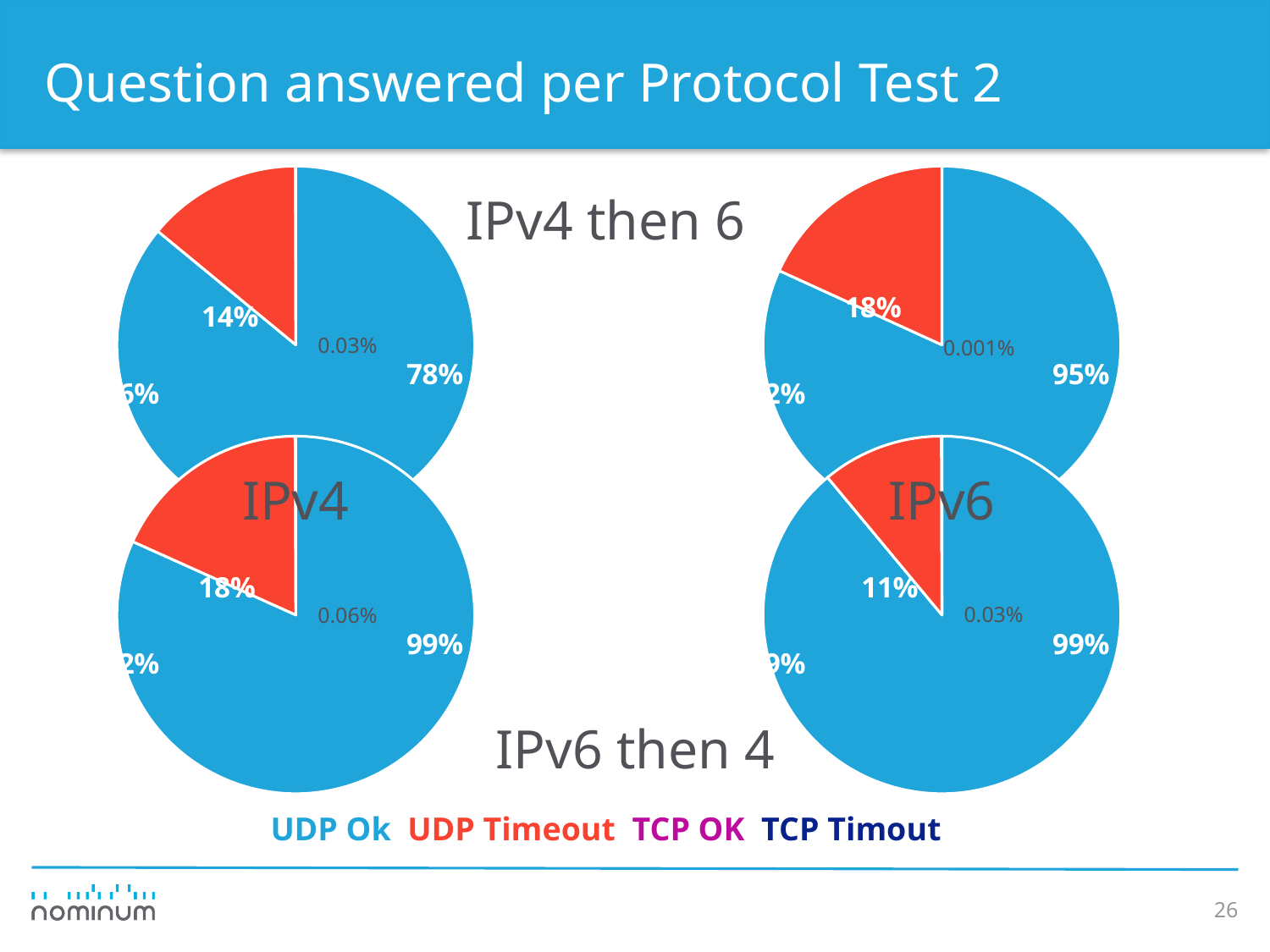
Which pie chart has the smallest red slice label: the top-left or the bottom-right? Bottom-right In the bottom-left pie chart, what is the small grey percentage label shown near the centre? 0.06% How many entries does the legend at the bottom of the slide list? 4 What is the difference between the red slice labels of the bottom-left pie (18%) and the top-left pie (14%)? 4 percentage points How many pie charts are shown on the slide? 4 In the top-right pie chart, what is the smallest percentage label shown near the centre? 0.001% What type of chart is used on this slide? Pie chart In the bottom-left pie chart, what percentage is labelled on the red slice? 18% In the top-left pie chart, what percentage is labelled on the red slice? 14% Which legend entry is shown in red? UDP Timeout In the top-right pie chart, what percentage is labelled on the red slice? 18% In the bottom-right pie chart, what percentage is labelled on the red slice? 11%